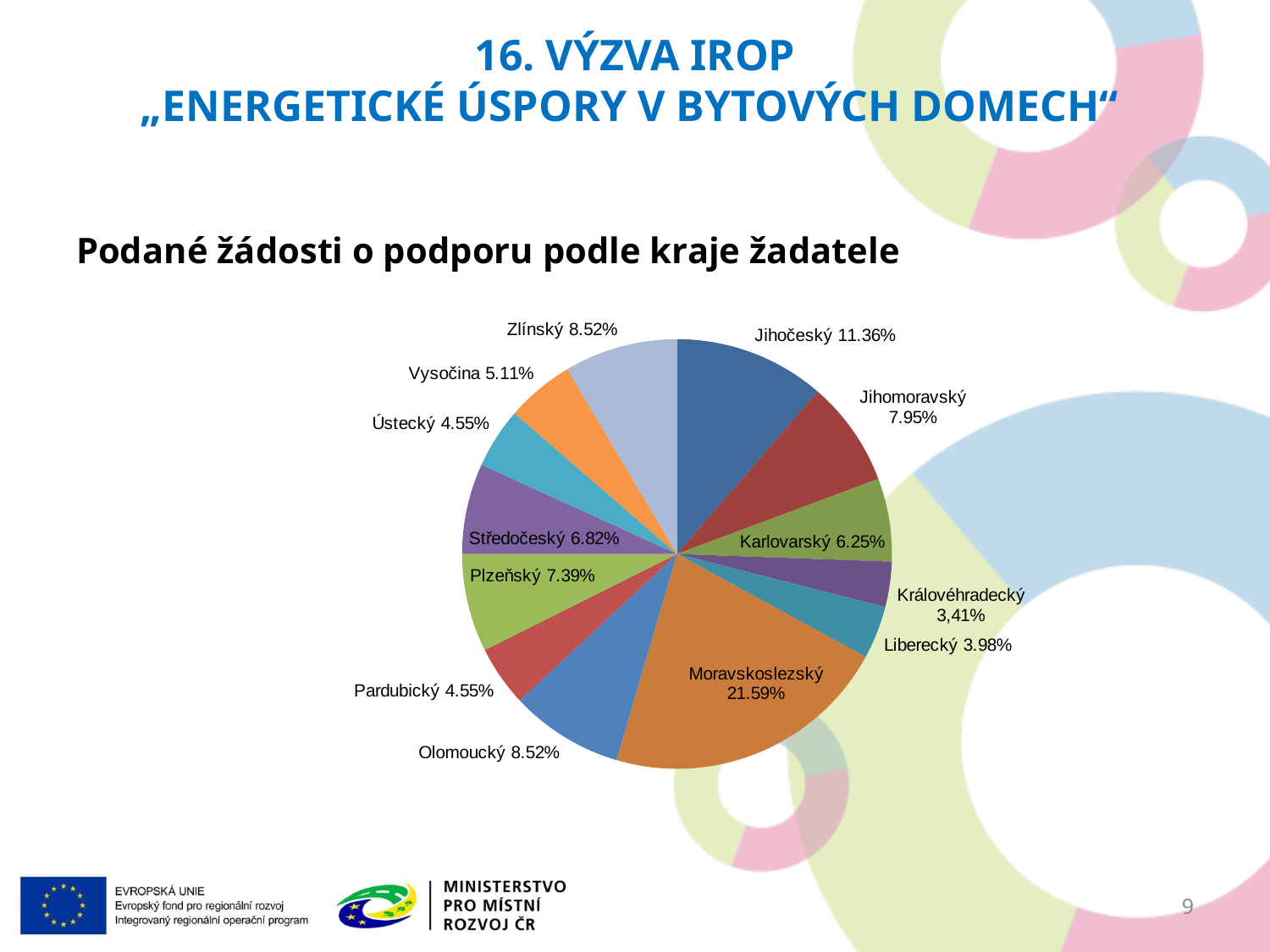
Which two regions both have a share of 8.52%? Zlínský and Olomoucký Which region has the largest slice of the pie? Moravskoslezský How many regions (slices) are shown in the pie chart? 13 What is the value shown for Plzeňský? 7.39% What kind of chart is shown on the slide? pie chart What share of the pie does Moravskoslezský have? 21.59% What is the value shown for Královéhradecký? 3,41% What is the value shown for Jihočeský? 11.36% Which region has the smallest slice of the pie? Královéhradecký What is the difference between the shares of Moravskoslezský and Jihočeský? 10.23% Which is larger, the share for Jihomoravský or the share for Karlovarský? Jihomoravský What is the title of the chart on the slide? Podané žádosti o podporu podle kraje žadatele